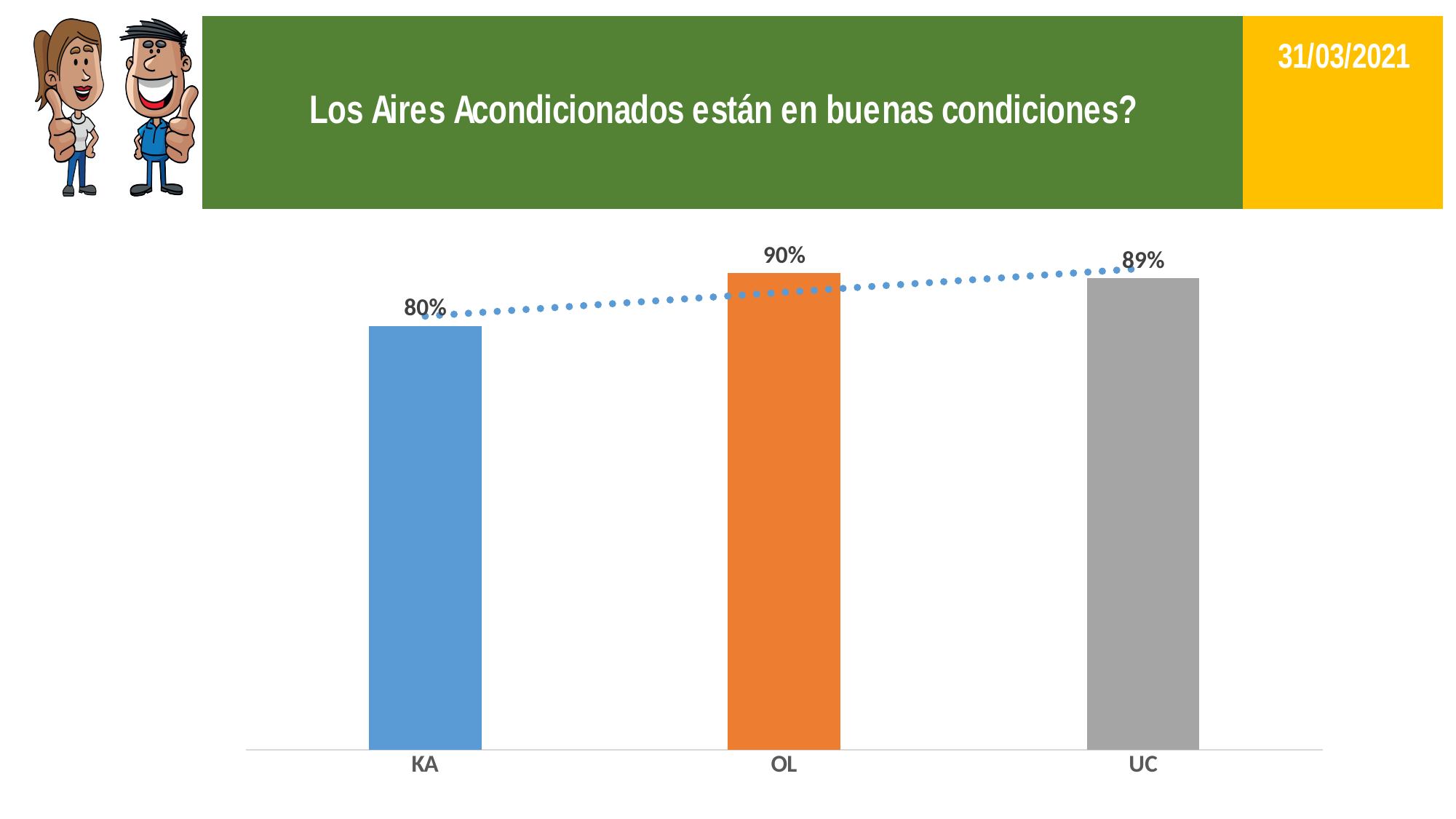
What is the difference between the values for UC and KA? 9% Which category has the highest value? OL Which is larger, the value for KA or the value for UC? UC What is the value for KA? 80% What colour is the bar for OL? Orange How many categories are shown on the chart? 3 What kind of chart is shown on the slide? Bar chart What is the value for OL? 90% What is the difference between the values for OL and KA? 10% What is the question shown in the title banner above the chart? Los Aires Acondicionados están en buenas condiciones? Which category has the lowest value? KA What is the value for UC? 89%